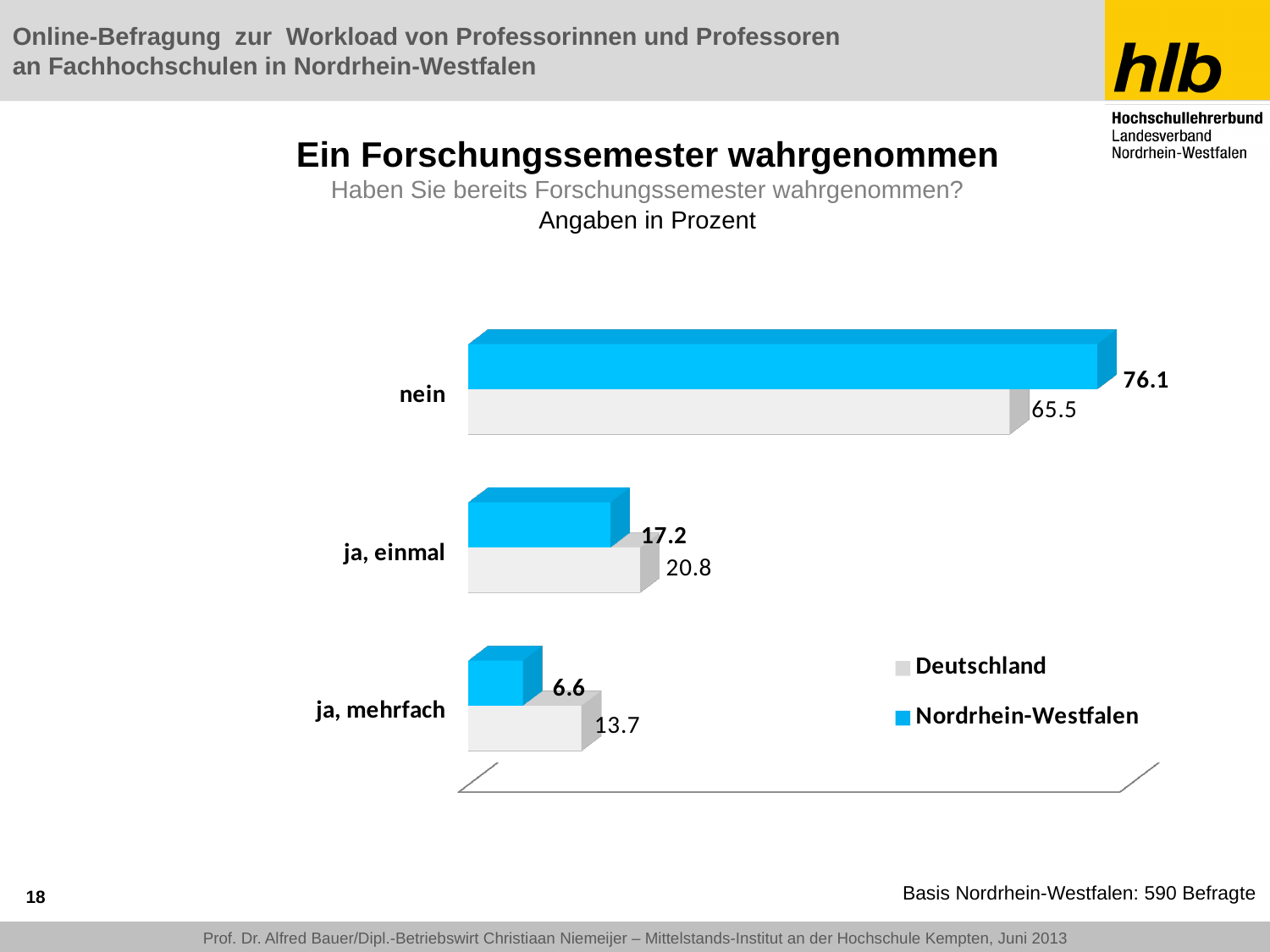
Which colour represents Nordrhein-Westfalen in the chart? blue What is the value for Nordrhein-Westfalen in the 'nein' category? 76.1 Which category has the highest value for Deutschland? nein What is the difference between the Nordrhein-Westfalen and Deutschland values in the 'nein' category? 10.6 How many series does the legend list? 2 How many categories are shown on the chart? 3 What is the value for Deutschland in the 'ja, einmal' category? 20.8 Which category has the lowest value for Nordrhein-Westfalen? ja, mehrfach What is the value for Deutschland in the 'ja, mehrfach' category? 13.7 What is the value for Nordrhein-Westfalen in the 'ja, mehrfach' category? 6.6 What kind of chart is shown on the slide? bar chart In the 'ja, einmal' category, which series has the larger value, Deutschland or Nordrhein-Westfalen? Deutschland